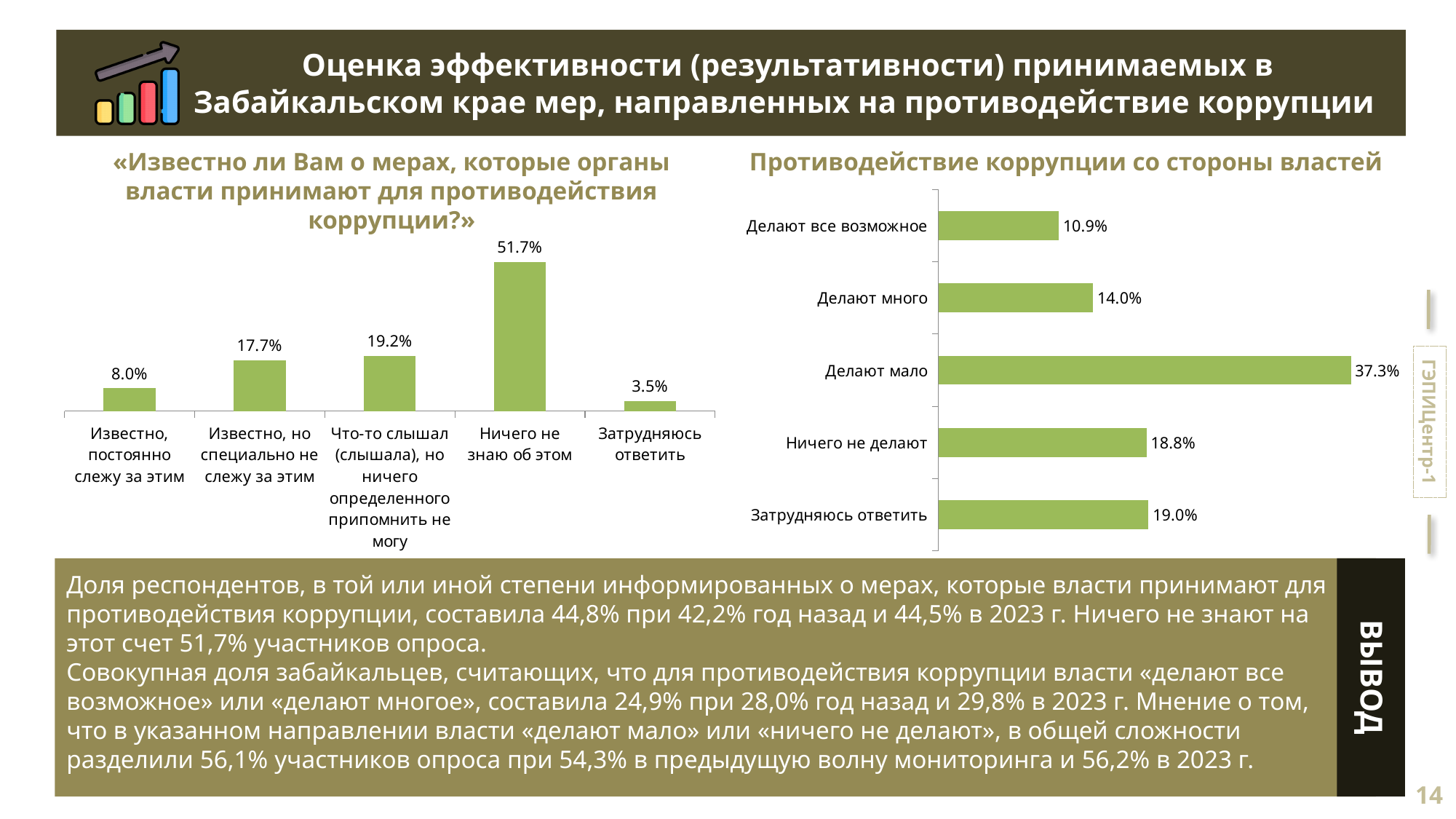
In the right chart «Противодействие коррупции со стороны властей», what is the difference between «Делают мало» and «Ничего не делают»? 18.5% In the left chart «Известно ли Вам о мерах...», what is the difference between «Что-то слышал (слышала), но ничего определенного припомнить не могу» and «Известно, но специально не слежу за этим»? 1.5% What type of chart is the right chart «Противодействие коррупции со стороны властей»? Bar chart In the right chart «Противодействие коррупции со стороны властей», which is larger: «Ничего не делают» or «Делают много»? Ничего не делают In the right chart «Противодействие коррупции со стороны властей», which category has the lowest value? Делают все возможное In the right chart «Противодействие коррупции со стороны властей», what is the value for «Делают много»? 14.0% In the left chart «Известно ли Вам о мерах...», how many categories are shown? 5 In the right chart «Противодействие коррупции со стороны властей», what is the value for «Делают мало»? 37.3% In the right chart «Противодействие коррупции со стороны властей», which category has the highest value? Делают мало In the left chart «Известно ли Вам о мерах...», what is the value for «Известно, постоянно слежу за этим»? 8.0% In the left chart «Известно ли Вам о мерах...», which category has the lowest value? Затрудняюсь ответить In the left chart «Известно ли Вам о мерах, которые органы власти принимают для противодействия коррупции?», what is the value for «Ничего не знаю об этом»? 51.7%